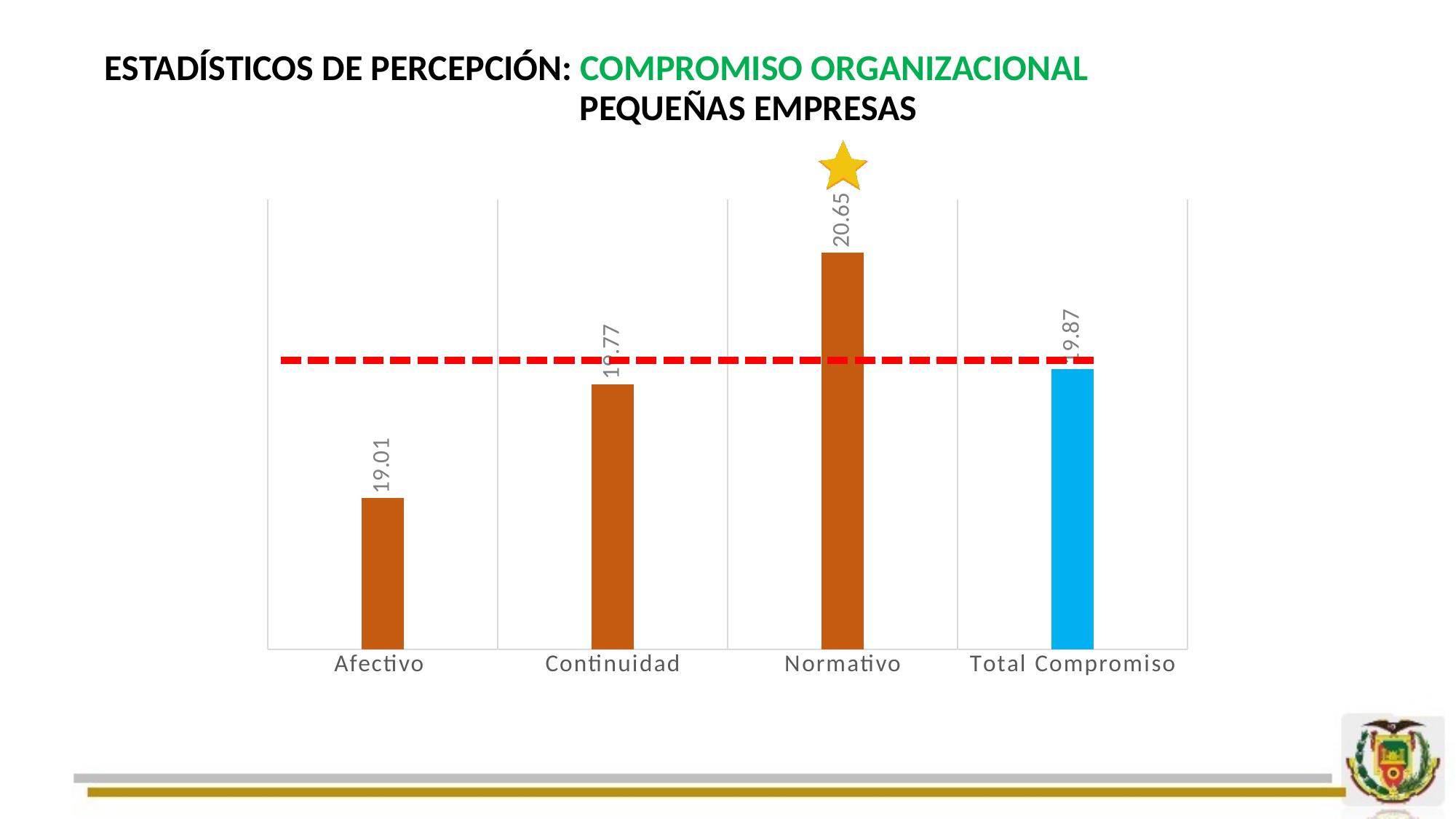
Which is larger, the value for Continuidad or the value for Normativo? Normativo What is the difference between the values for Total Compromiso and Continuidad? 0.10 What is the difference between the values for Normativo and Afectivo? 1.64 Which bar is shown in a different colour (blue) from the others? Total Compromiso Which category has the highest value? Normativo What is the value for Normativo? 20.65 How many categories are shown on the x axis? 4 What is the value for Continuidad? 19.77 What is the value for Total Compromiso? 19.87 What is the value for Afectivo? 19.01 What kind of chart is shown on the slide? Bar chart Which category has the lowest value? Afectivo